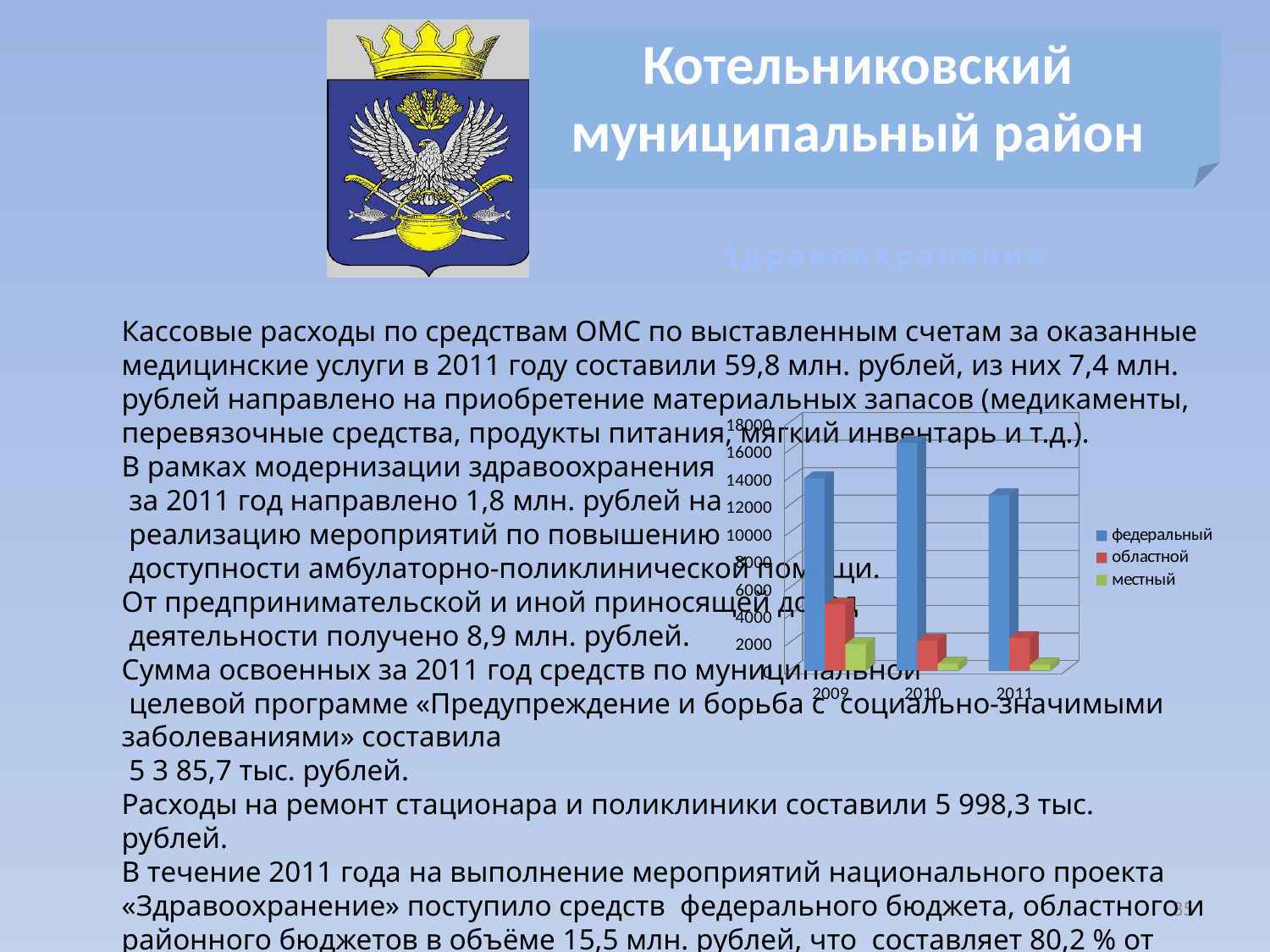
Is the областной value for 2009 greater or less than 4000? greater In which year is the федеральный value highest? 2010 How many series does the chart legend list? 3 In which year is the областной value highest? 2009 Which series is shown in blue in the chart legend? федеральный Is the местный value for 2010 greater or less than 2000? less Which is larger, the областной value for 2009 or the областной value for 2011? 2009 Is the федеральный value for 2009 greater or less than 12000? greater Which series is shown in green in the chart legend? местный How many years are shown on the x axis of the chart? 3 What kind of chart is shown on the slide? bar chart